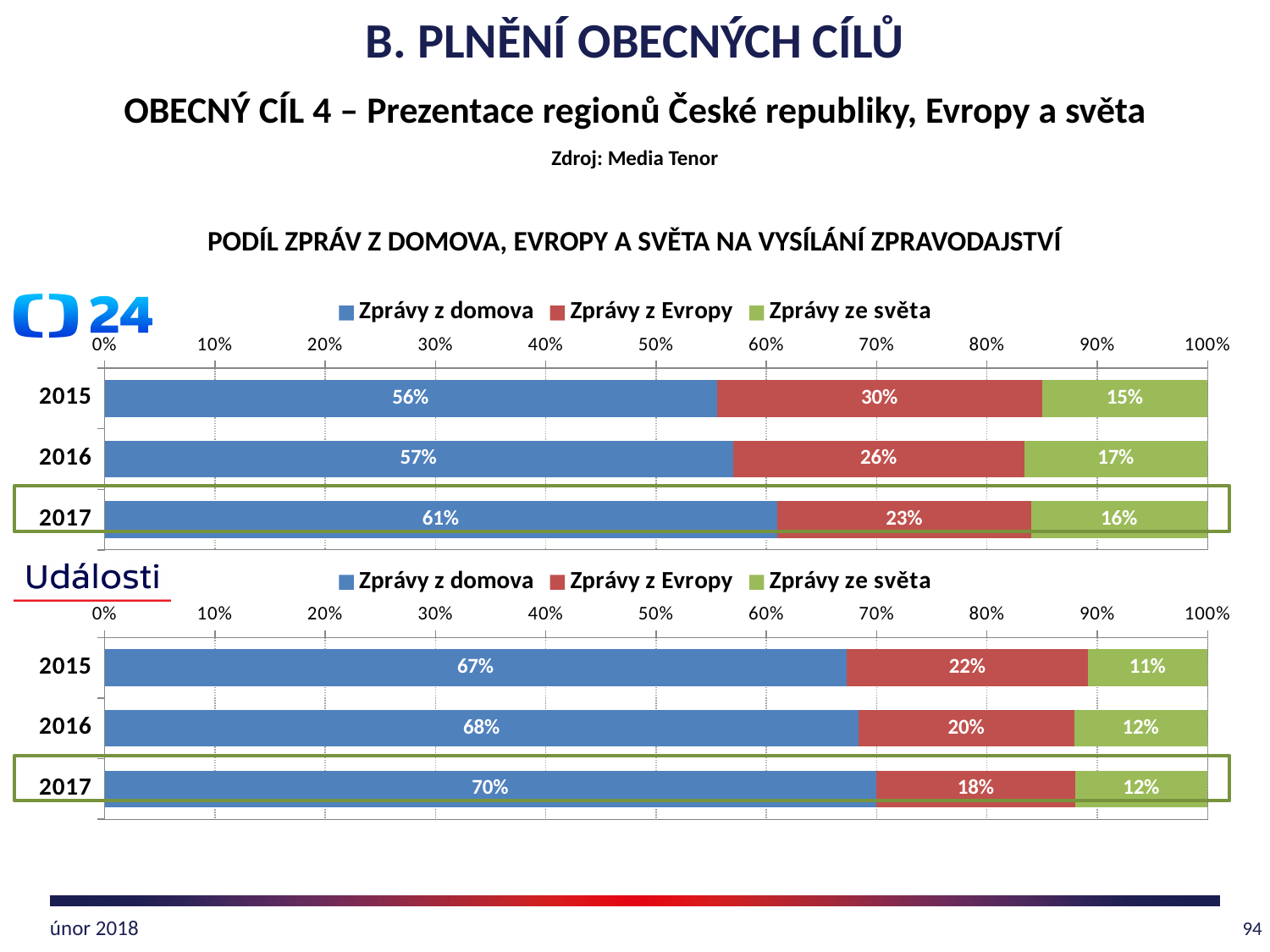
How many series does the legend of the top chart (ČT24) list? 3 In the top chart (ČT24), which year has the lowest value for Zprávy z Evropy? 2017 How many years are shown in the bottom chart (Události)? 3 In the bottom chart (Události), which year has the highest value for Zprávy z domova? 2017 What kind of chart is the top chart (ČT24)? Stacked bar chart In the top chart (ČT24), what is the value for Zprávy z domova in 2017? 61% In the bottom chart (Události), what is the value for Zprávy z Evropy in 2015? 22% In the bottom chart (Události), which series is shown in green? Zprávy ze světa In the top chart (ČT24), which is larger: Zprávy z Evropy in 2015 or Zprávy z Evropy in 2016? Zprávy z Evropy in 2015 In the bottom chart (Události), what is the difference between Zprávy z domova in 2017 and in 2015? 3% In the top chart (ČT24), what is the value for Zprávy ze světa in 2016? 17% In the top chart (ČT24), does the value for Zprávy z domova rise or fall from 2015 to 2017? Rise